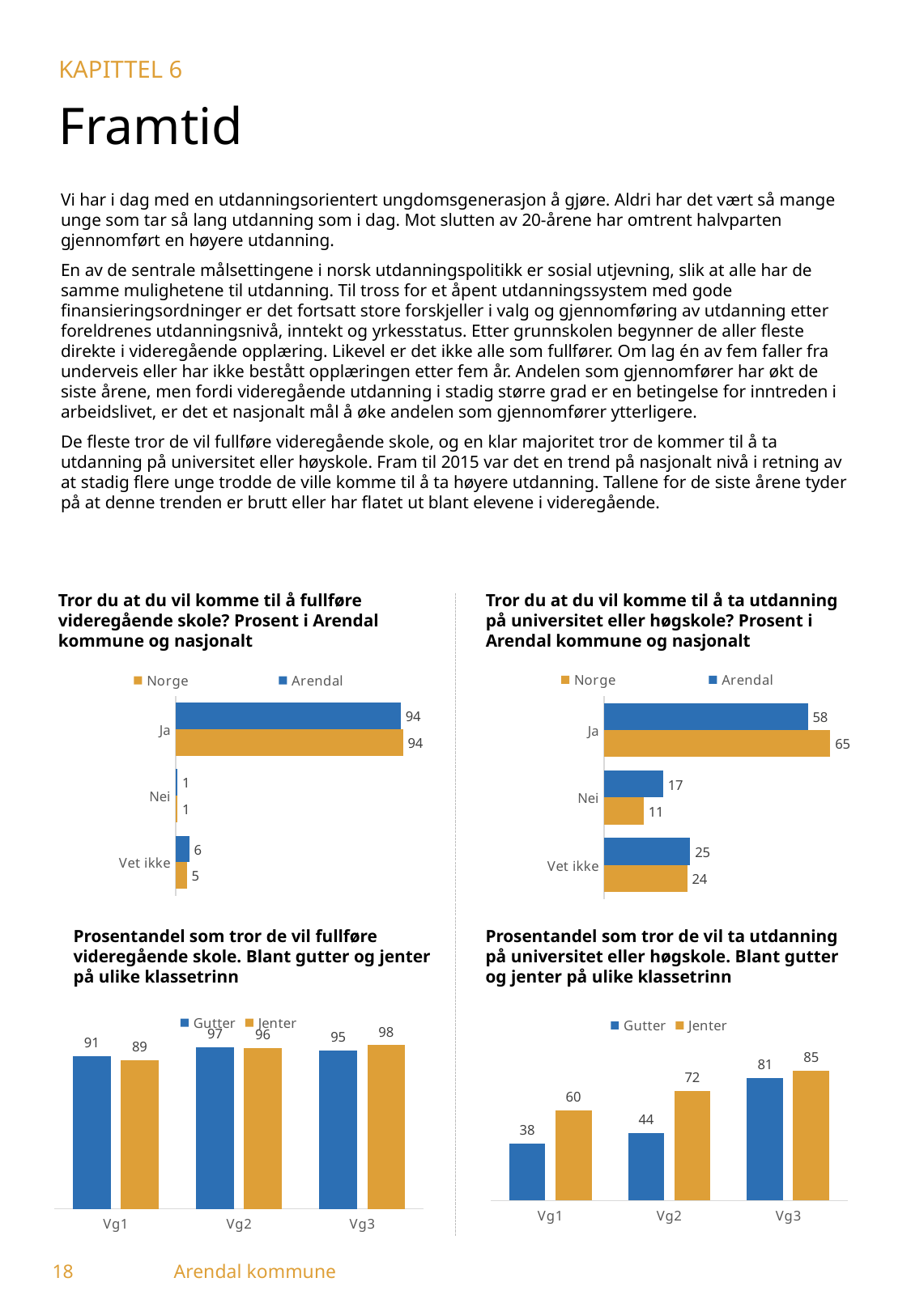
In the bottom-right chart (Prosentandel som tror de vil ta utdanning på universitet eller høgskole), what is the difference between Jenter and Gutter at Vg2? 28 In the top-left chart (Tror du at du vil komme til å fullføre videregående skole?), what is the value for Arendal for 'Ja'? 94 In the top-left chart (Tror du at du vil komme til å fullføre videregående skole?), what is the value for Norge for 'Vet ikke'? 5 In the top-right chart (Tror du at du vil komme til å ta utdanning på universitet eller høgskole?), what is the difference between Arendal and Norge for 'Nei'? 6 In the bottom-right chart (Prosentandel som tror de vil ta utdanning på universitet eller høgskole), do the values for Gutter rise or fall from Vg1 to Vg3? Rise In the bottom-left chart (Prosentandel som tror de vil fullføre videregående skole), how many class levels are shown on the x axis? 3 In the bottom-right chart (Prosentandel som tror de vil ta utdanning på universitet eller høgskole), which class level has the lowest value for Gutter? Vg1 In the bottom-left chart (Prosentandel som tror de vil fullføre videregående skole), what is the value for Jenter at Vg3? 98 In the top-right chart (Tror du at du vil komme til å ta utdanning på universitet eller høgskole?), which is larger for 'Ja': Arendal or Norge? Norge In the top-right chart (Tror du at du vil komme til å ta utdanning på universitet eller høgskole?), how many series does the legend list? 2 In the top-right chart (Tror du at du vil komme til å ta utdanning på universitet eller høgskole?), what is the value for Norge for 'Ja'? 65 In the top-left chart (Tror du at du vil komme til å fullføre videregående skole?), what kind of chart is shown? Bar chart